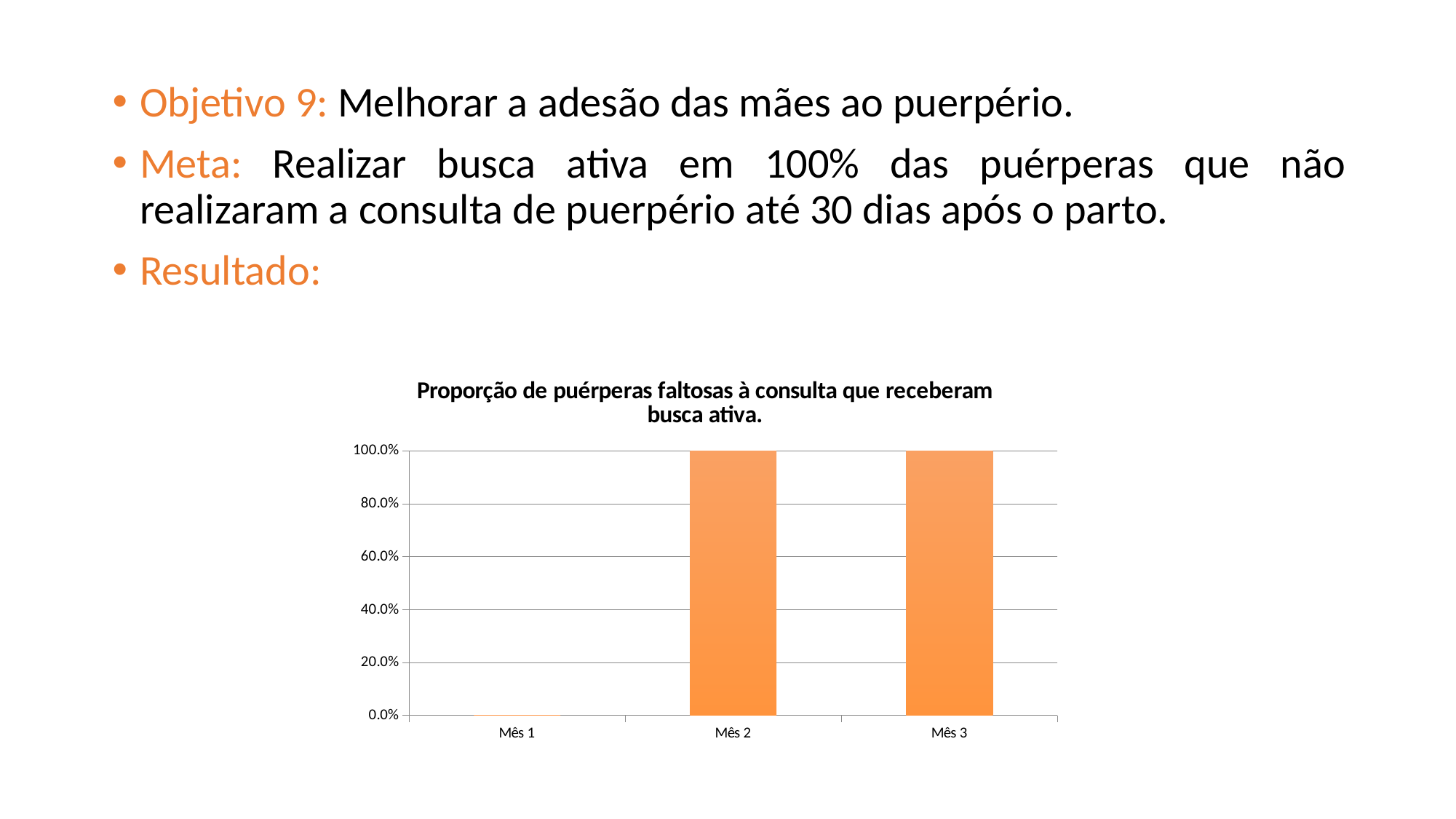
What is the title of the chart? Proporção de puérperas faltosas à consulta que receberam busca ativa. What is the difference between the values for Mês 2 and Mês 1? 100.0% Is the value for Mês 3 greater or less than 80.0%? greater How many categories are shown on the x axis of the chart? 3 What is the value for Mês 2? 100.0% Which is larger, the value for Mês 1 or the value for Mês 2? Mês 2 Does the value rise or fall from Mês 1 to Mês 2? rise What is the value for Mês 3? 100.0% What kind of chart is shown on the slide? bar chart Is the value for Mês 1 greater or less than 20.0%? less Which category has the lowest value? Mês 1 What is the value for Mês 1? 0.0%